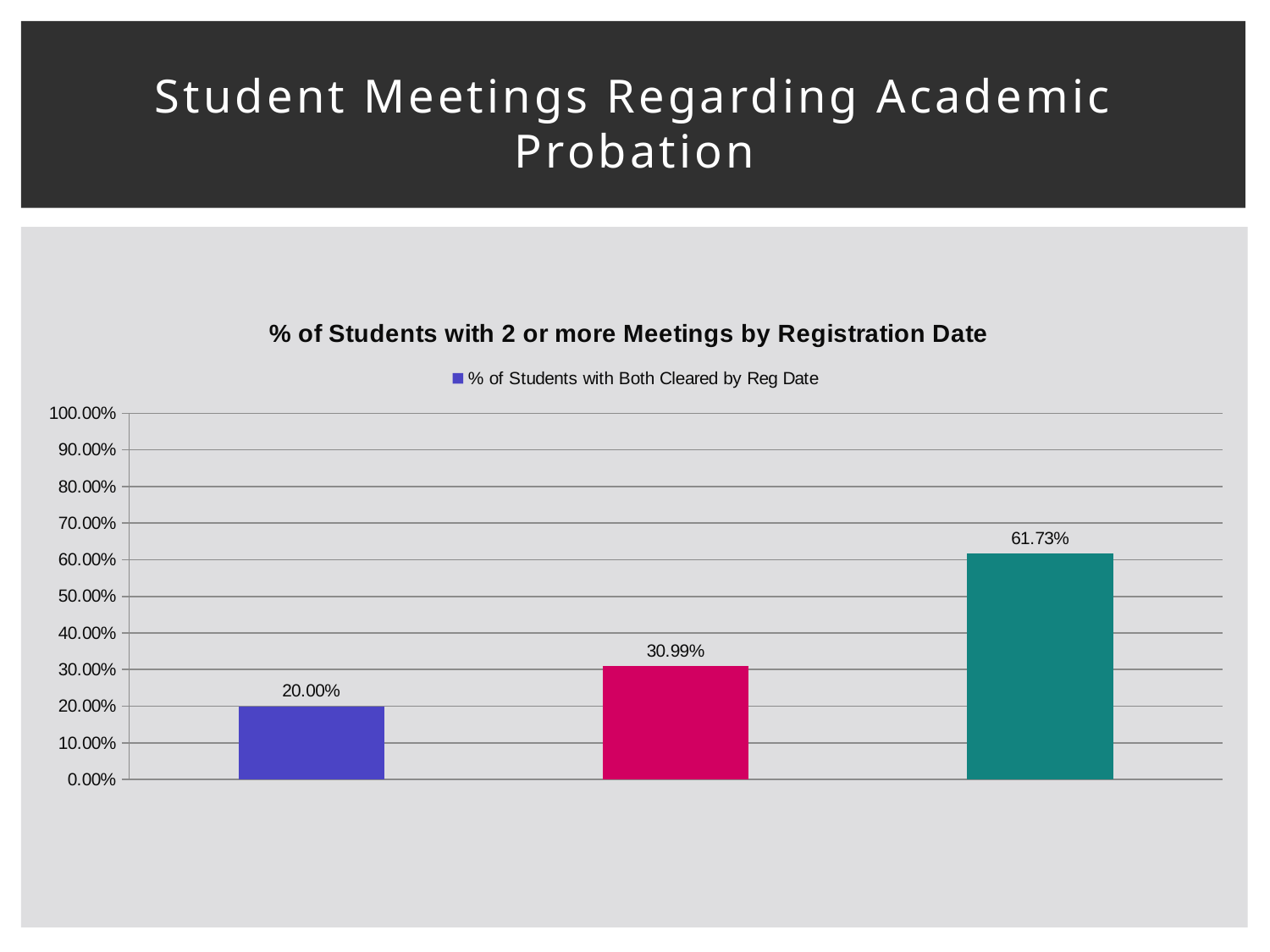
Which is larger, the middle bar or the rightmost bar? the rightmost bar Which bar has the lowest value: the left, middle, or right bar? left What is the value of the rightmost (teal) bar? 61.73% What is the value of the middle bar? 30.99% What is the difference between the rightmost bar and the leftmost bar? 41.73% What kind of chart is shown on the slide? bar chart How many series does the legend list? 1 What is the difference between the middle bar and the leftmost bar? 10.99% How many bars are plotted in the chart? 3 What is the value of the leftmost bar? 20.00% Which bar has the highest value: the left, middle, or right bar? right Do the bar values rise or fall from left to right? rise